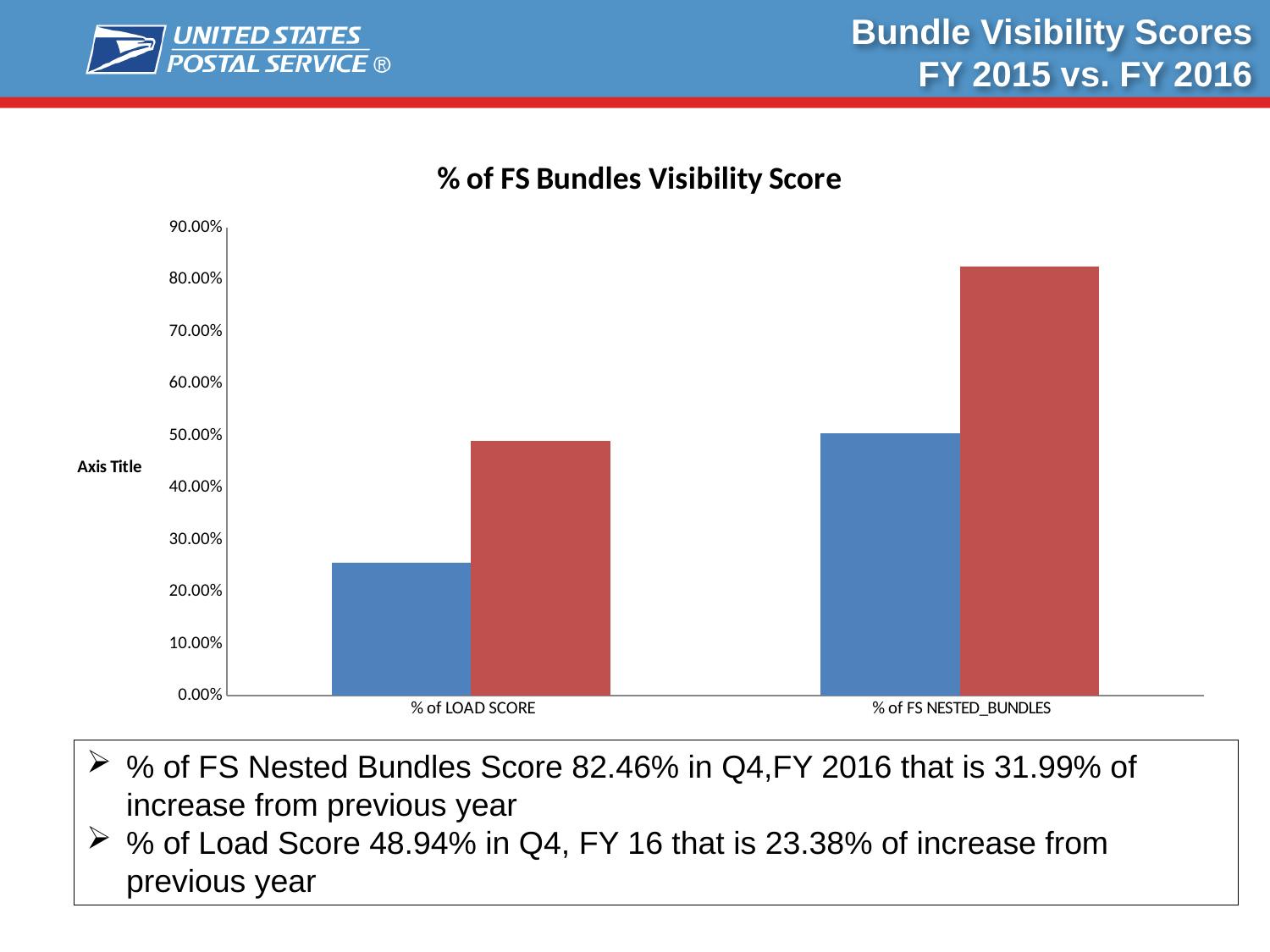
Is the value of the red bar for % of FS NESTED_BUNDLES greater or less than 80.00%? greater Which category has the taller blue bar, % of LOAD SCORE or % of FS NESTED_BUNDLES? % of FS NESTED_BUNDLES Within the % of LOAD SCORE category, which bar is taller, the blue one or the red one? the red one What label is shown on the vertical axis of the chart? Axis Title Is the value of the blue bar for % of LOAD SCORE greater or less than 30.00%? less Which category contains the tallest bar in the chart? % of FS NESTED_BUNDLES Is the value of the red bar for % of LOAD SCORE greater or less than 40.00%? greater Which category has the taller red bar, % of LOAD SCORE or % of FS NESTED_BUNDLES? % of FS NESTED_BUNDLES What type of chart is shown on the slide? bar chart What is the title of the chart? % of FS Bundles Visibility Score How many categories are shown on the x axis of the chart? 2